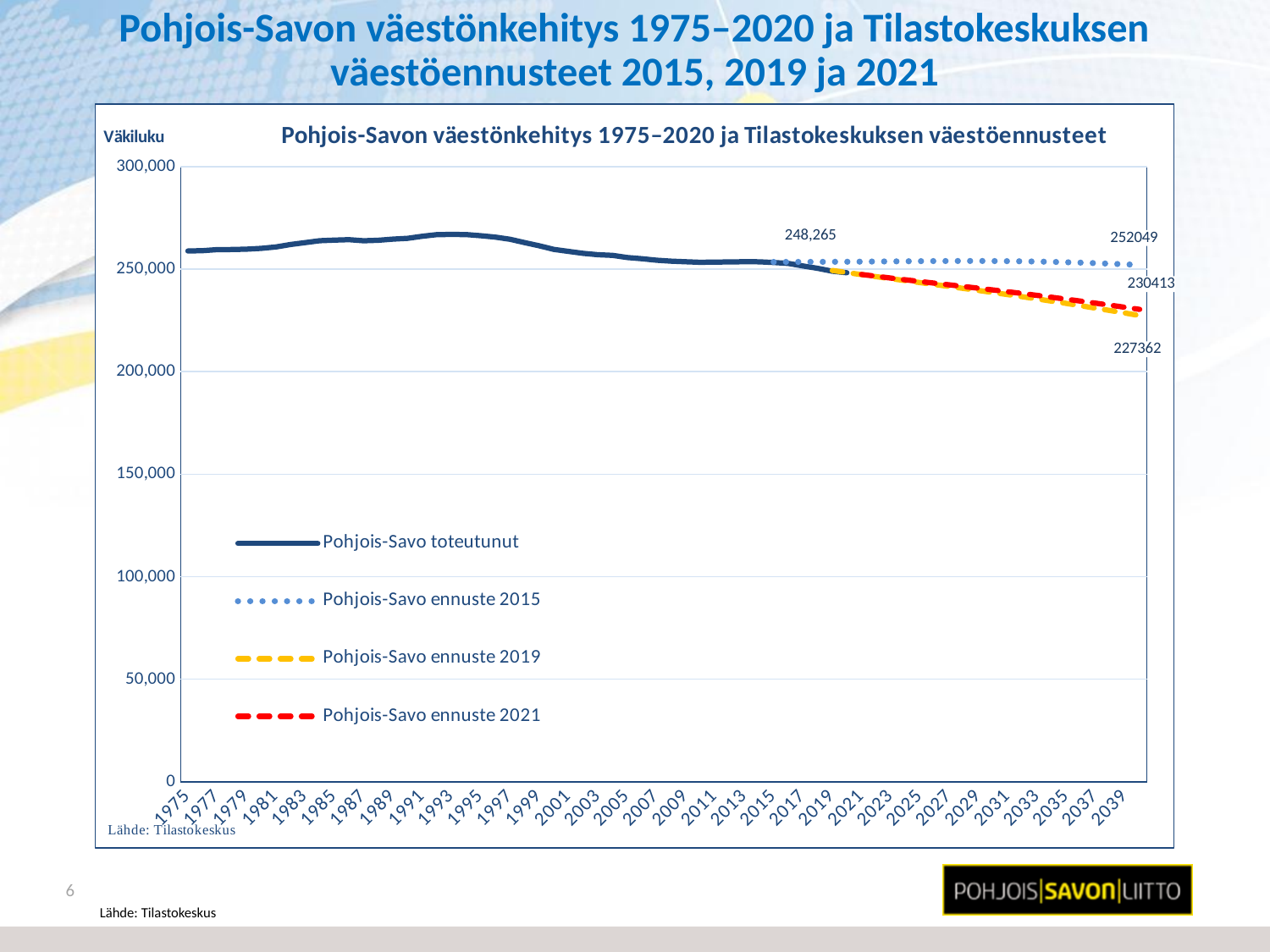
What is the difference between the final values of the ennuste 2015 and ennuste 2019 series? 24687 How many series does the legend list? 4 What is the final labelled value of the Pohjois-Savo ennuste 2015 series? 252049 Is the value of the Pohjois-Savo toteutunut line in 1993 greater or less than 250,000? greater What kind of chart is shown on the slide? line chart What is the final labelled value of the Pohjois-Savo ennuste 2021 series? 230413 What is the difference between the final values of the ennuste 2021 and ennuste 2019 series? 3051 Does the Pohjois-Savo toteutunut line rise or fall between 2000 and 2020? fall Which forecast series ends at the lowest value? Pohjois-Savo ennuste 2019 What value is printed as a data label near the point where the forecast lines begin? 248,265 What is the final labelled value of the Pohjois-Savo ennuste 2019 series? 227362 Which forecast series ends at the highest value? Pohjois-Savo ennuste 2015